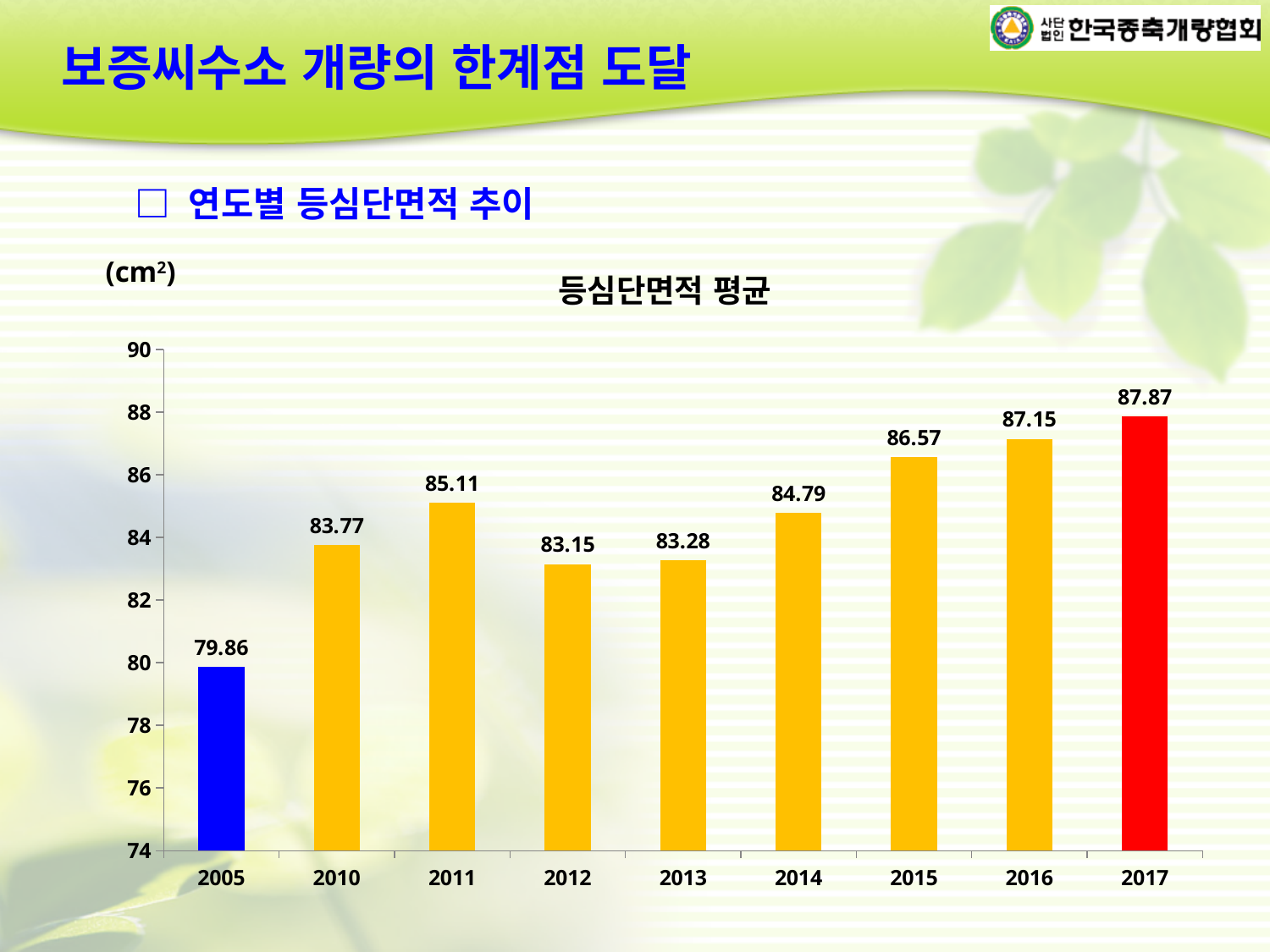
What is the title of the chart? 등심단면적 평균 What is the difference between the values for 2011 and 2012? 1.96 Which year has the highest value? 2017 What is the value for 2005? 79.86 How many years are shown on the x axis? 9 What is the value for 2014? 84.79 Which year has the lowest value? 2005 What kind of chart is shown on the slide? bar chart What is the difference between the values for 2017 and 2005? 8.01 Which is larger, the value for 2011 or the value for 2013? 2011 What is the value for 2017? 87.87 Is the value for 2010 greater or less than 82? greater